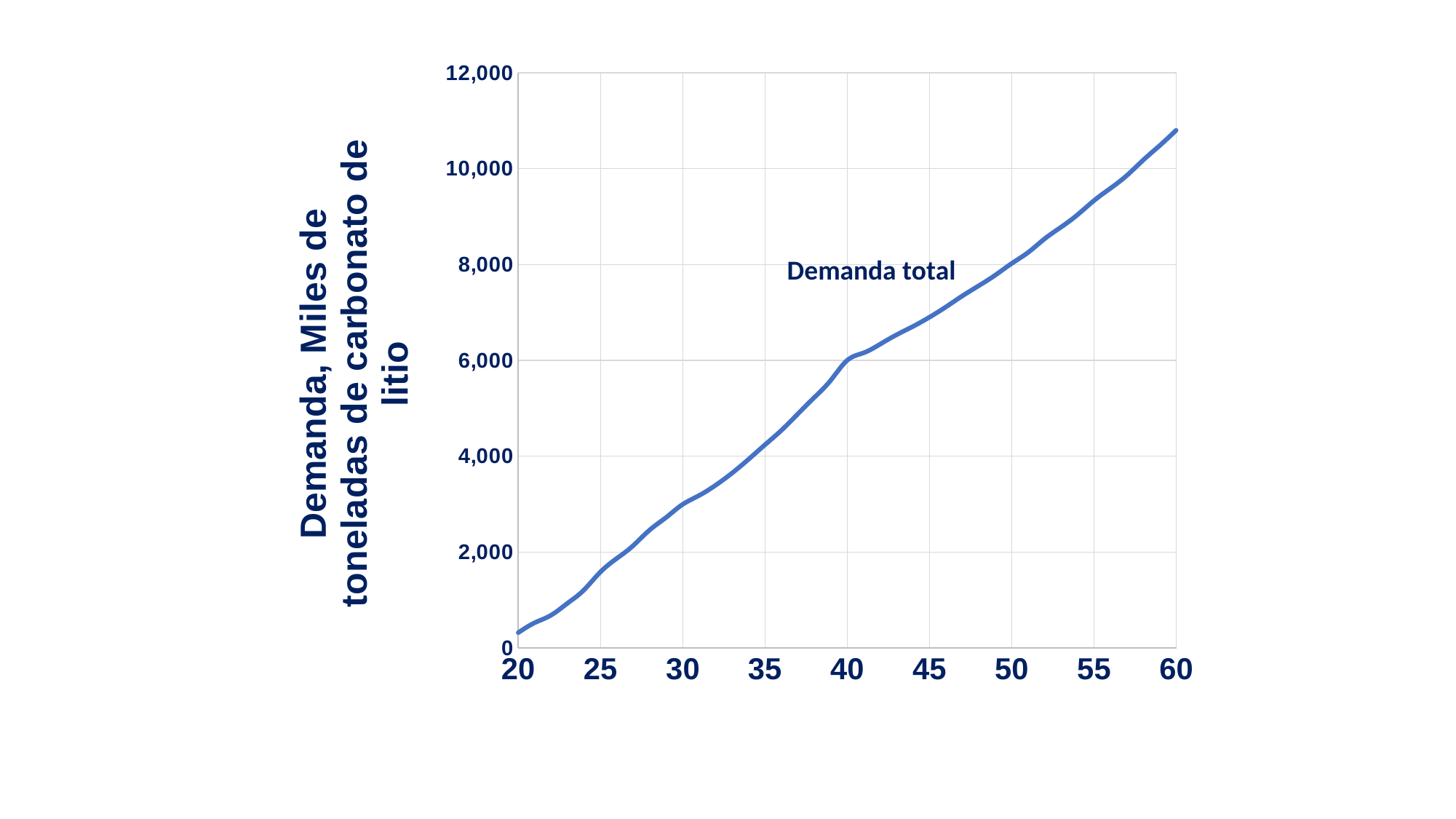
What is the y-axis title of the chart? Demanda, Miles de toneladas de carbonato de litio At which x-axis value is Demanda total lowest? 20 How many series are plotted on the chart? 1 Is the value of Demanda total at 20 greater or less than 2,000? less Which is larger, Demanda total at 30 or at 50? at 50 Does the Demanda total line rise or fall as the x axis goes from 20 to 60? rise Is the value of Demanda total at 55 greater or less than 8,000? greater Is the value of Demanda total at 60 greater or less than 10,000? greater What kind of chart is shown on the slide? line chart What is the name of the series plotted on the chart? Demanda total At which x-axis value is Demanda total highest? 60